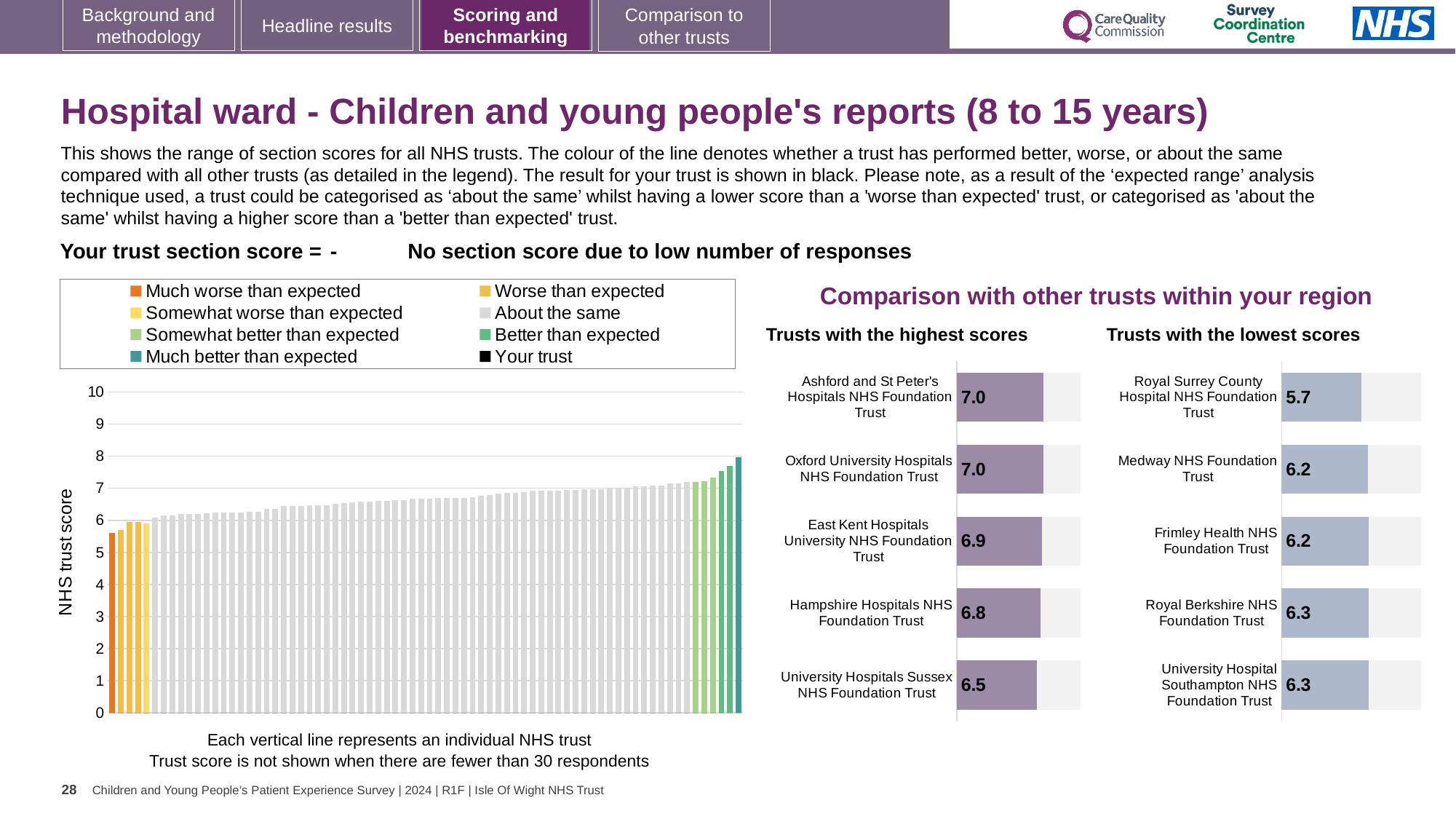
Which has the higher score: Hampshire Hospitals NHS Foundation Trust in the highest scores chart or Medway NHS Foundation Trust in the lowest scores chart? Hampshire Hospitals NHS Foundation Trust In the 'Trusts with the lowest scores' chart, what is the difference between the scores of Royal Berkshire NHS Foundation Trust and Royal Surrey County Hospital NHS Foundation Trust? 0.6 In the main 'NHS trust score' chart, do the bar values rise or fall from left to right? rise How many entries does the legend of the main 'NHS trust score' chart list? 8 In the 'Trusts with the lowest scores' chart, what is the score for Royal Surrey County Hospital NHS Foundation Trust? 5.7 What kind of chart is the main chart on the left showing NHS trust scores? bar chart In the 'Trusts with the highest scores' chart, what is the score for Hampshire Hospitals NHS Foundation Trust? 6.8 How many trusts are listed in the 'Trusts with the highest scores' chart? 5 In the 'Trusts with the highest scores' chart, what is the difference between the scores of Ashford and St Peter's Hospitals NHS Foundation Trust and University Hospitals Sussex NHS Foundation Trust? 0.5 In the 'Trusts with the highest scores' chart, what is the score for East Kent Hospitals University NHS Foundation Trust? 6.9 In the 'Trusts with the lowest scores' chart, which trust has the lowest score? Royal Surrey County Hospital NHS Foundation Trust In the 'Trusts with the highest scores' chart, which trust has the lowest score? University Hospitals Sussex NHS Foundation Trust